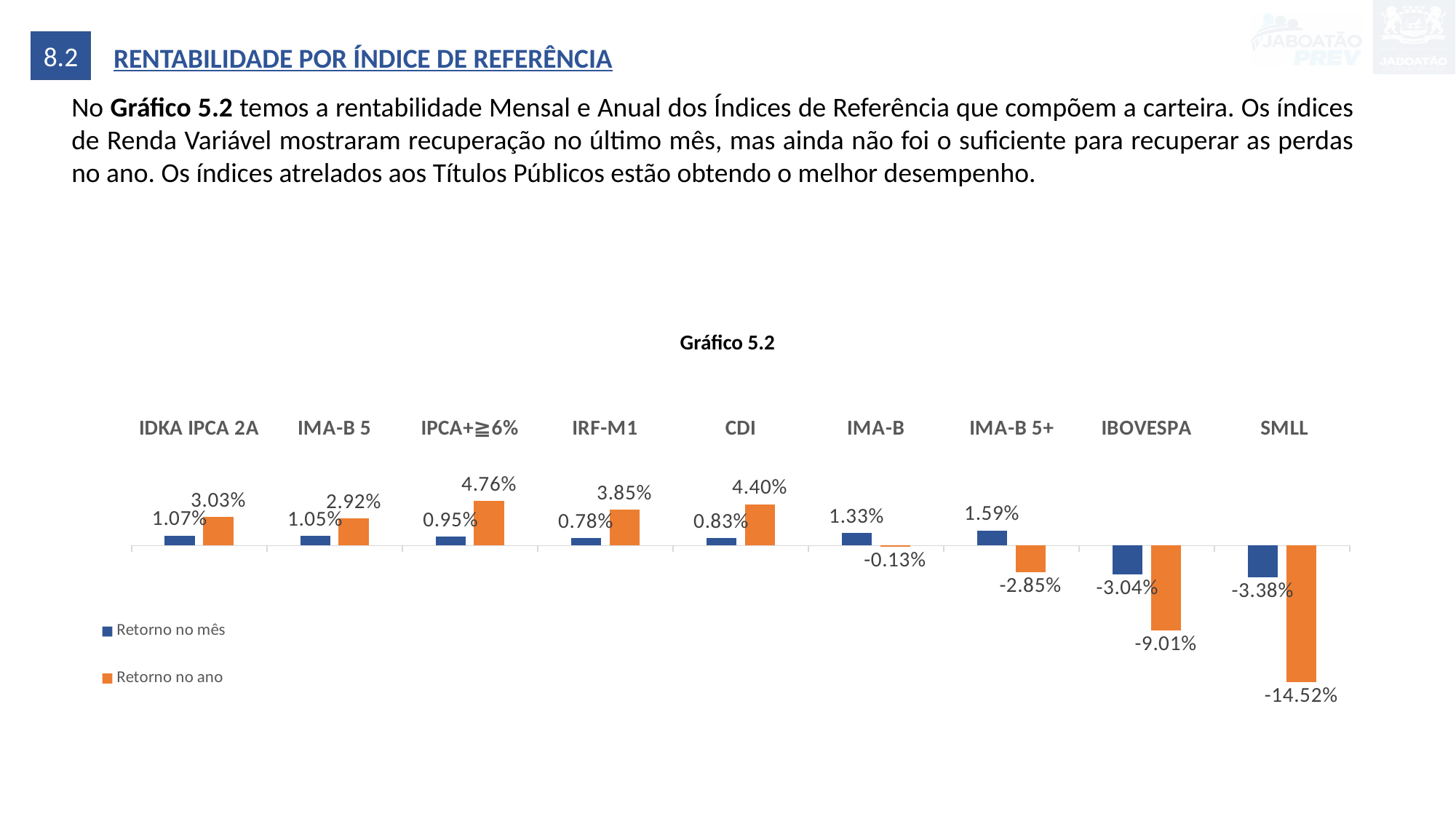
What is the 'Retorno no mês' value for IMA-B 5+? 1.59% Which index has the highest 'Retorno no mês' value? IMA-B 5+ Which is larger: the 'Retorno no ano' for IDKA IPCA 2A or for IMA-B 5? IDKA IPCA 2A Which index has the lowest 'Retorno no ano' value? SMLL How many indices are shown on the x axis of the chart? 9 What is the difference between the 'Retorno no ano' and 'Retorno no mês' values for IRF-M1? 3.07% What is the 'Retorno no ano' value for IBOVESPA? -9.01% Which index has the highest 'Retorno no ano' value? IPCA+≧6% What is the 'Retorno no ano' value for CDI? 4.40% What are the two series named in the legend? Retorno no mês and Retorno no ano How many series does the legend list? 2 What kind of chart is Gráfico 5.2? Bar chart